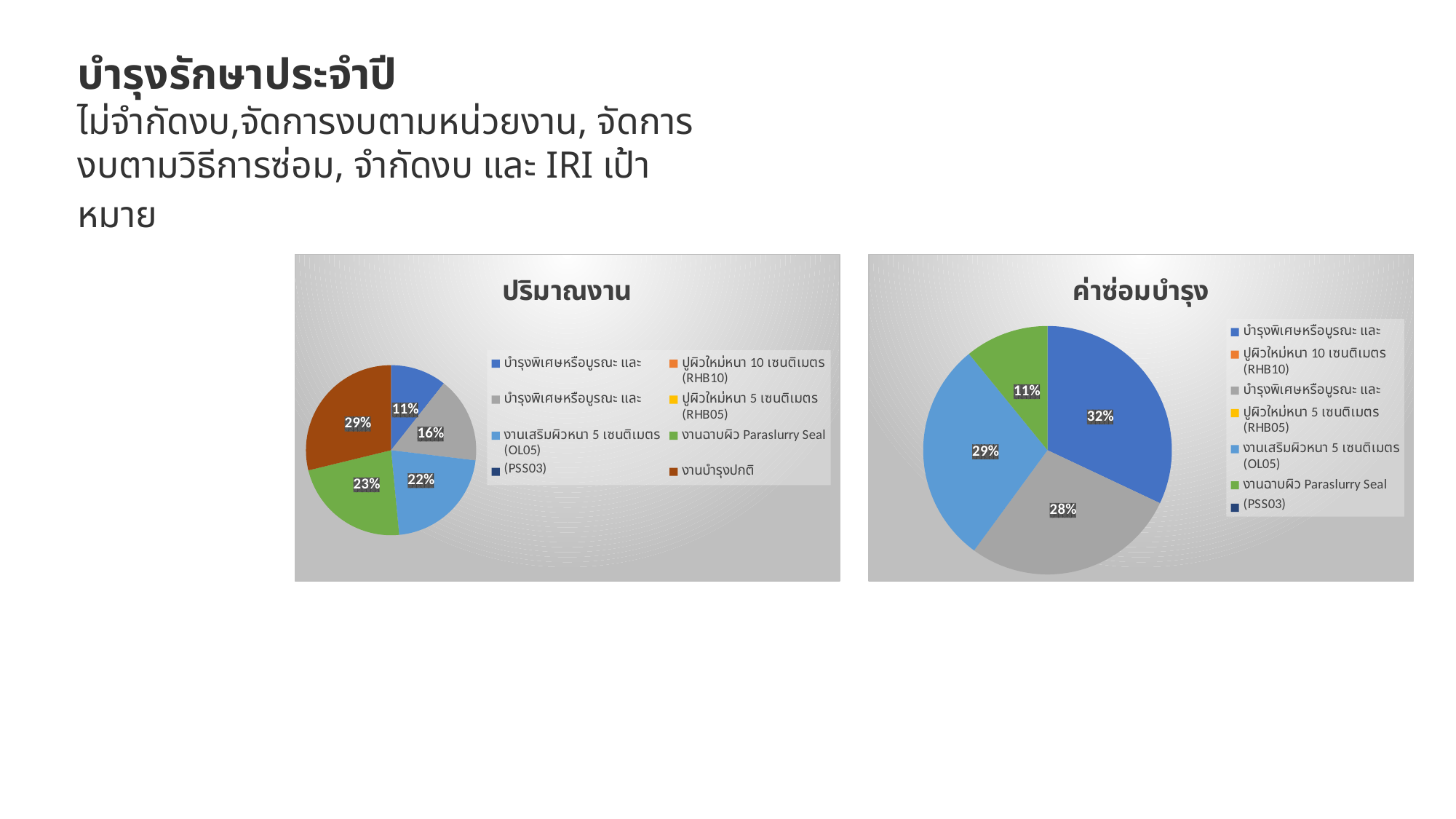
In the chart titled ค่าซ่อมบำรุง, what is the difference in percentage points between the largest slice and the smallest slice? 21 percentage points In the chart titled ปริมาณงาน, what share does งานบำรุงปกติ have? 29% In the chart titled ค่าซ่อมบำรุง, which is larger: the slice for งานเสริมผิวหนา 5 เซนติเมตร (OL05) or the slice for งานฉาบผิว Paraslurry Seal? งานเสริมผิวหนา 5 เซนติเมตร (OL05) In the chart titled ปริมาณงาน, what share does งานฉาบผิว Paraslurry Seal have? 23% In the chart titled ค่าซ่อมบำรุง, what share does งานฉาบผิว Paraslurry Seal have? 11% What kind of chart is the chart titled ปริมาณงาน? Pie chart How many slices are shown in the chart titled ปริมาณงาน? 5 In the chart titled ค่าซ่อมบำรุง, what is the percentage of the largest slice? 32% In the chart titled ปริมาณงาน, what is the percentage of the smallest slice? 11% In the chart titled ปริมาณงาน, which category has the largest slice? งานบำรุงปกติ